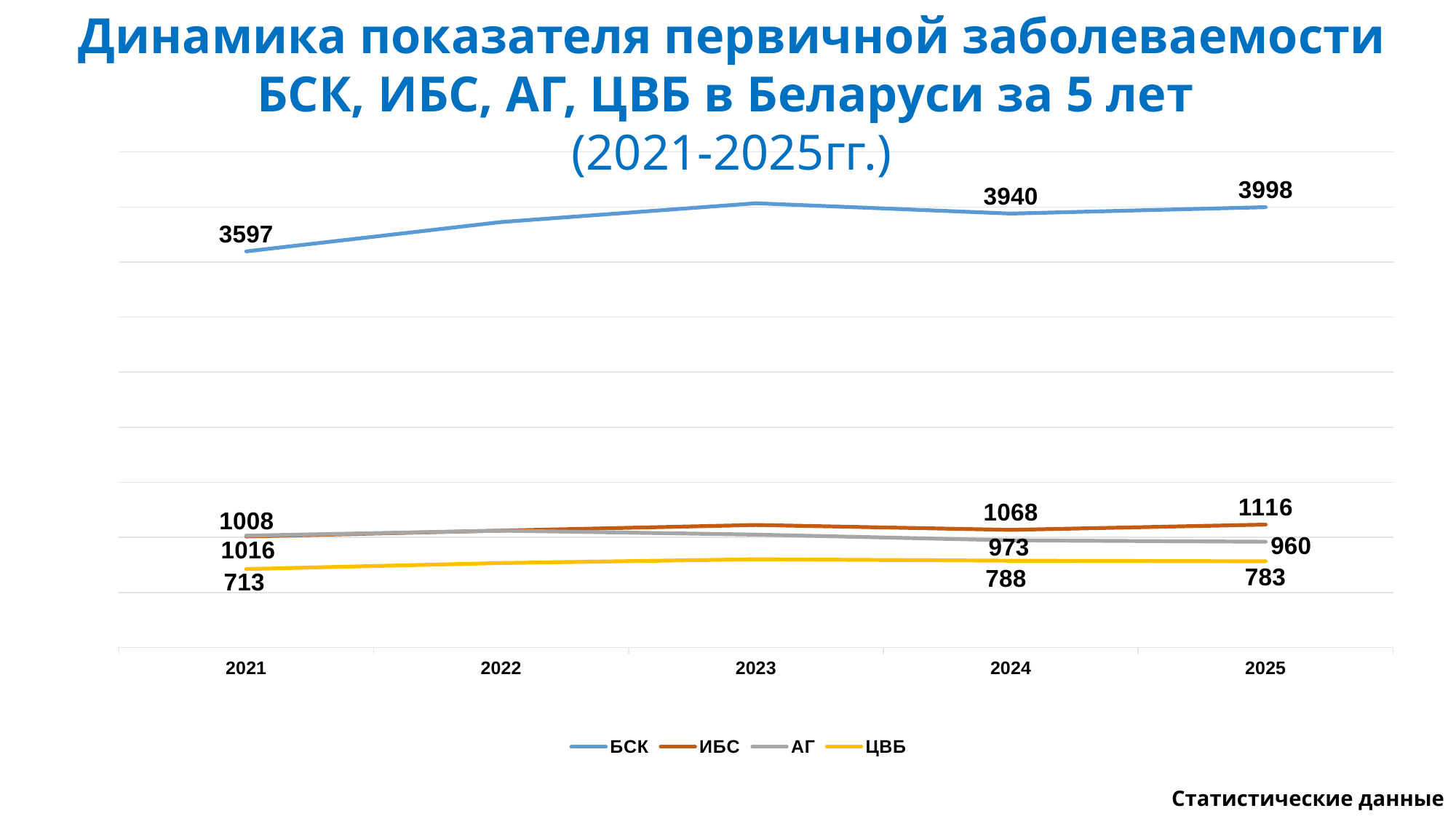
What is the value for БСК in 2021? 3597 By how much did the БСК value increase from 2021 to 2025? 401 What is the value for БСК in 2025? 3998 How many years are shown on the x axis? 5 What kind of chart is shown on the slide? line chart What is the value for ИБС in 2025? 1116 Which is larger in 2025, ИБС or АГ? ИБС What is the value for ЦВБ in 2024? 788 What is the value for АГ in 2025? 960 How many series does the legend list? 4 Which series has the lowest value in 2025? ЦВБ Which series has the highest value in 2025? БСК